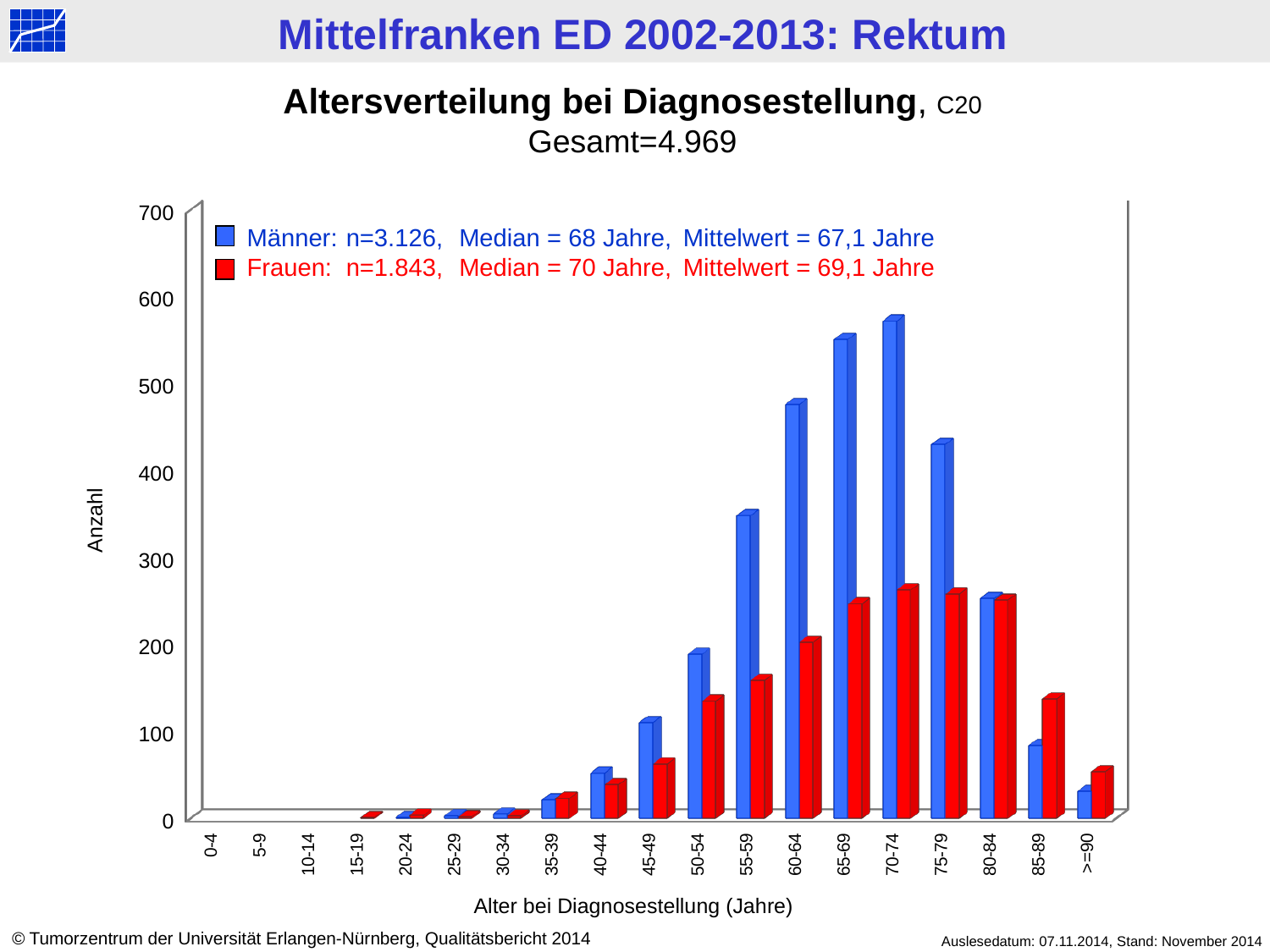
How many series does the legend list? 2 How many age groups are shown on the x axis? 19 In the 85-89 age group, which series has the larger value, Männer or Frauen? Frauen What kind of chart is shown on the slide? bar chart Is the value for Männer in the 65-69 age group greater or less than 500? greater Is the value for Männer in the 85-89 age group greater or less than 100? less In the 60-64 age group, which series has the larger value, Männer or Frauen? Männer According to the legend, what is n for Männer? 3.126 Which age group has the highest value for Männer? 70-74 Do the values for Männer rise or fall from the 70-74 age group to the >=90 age group? fall Is the value for Männer in the 55-59 age group greater or less than 300? greater